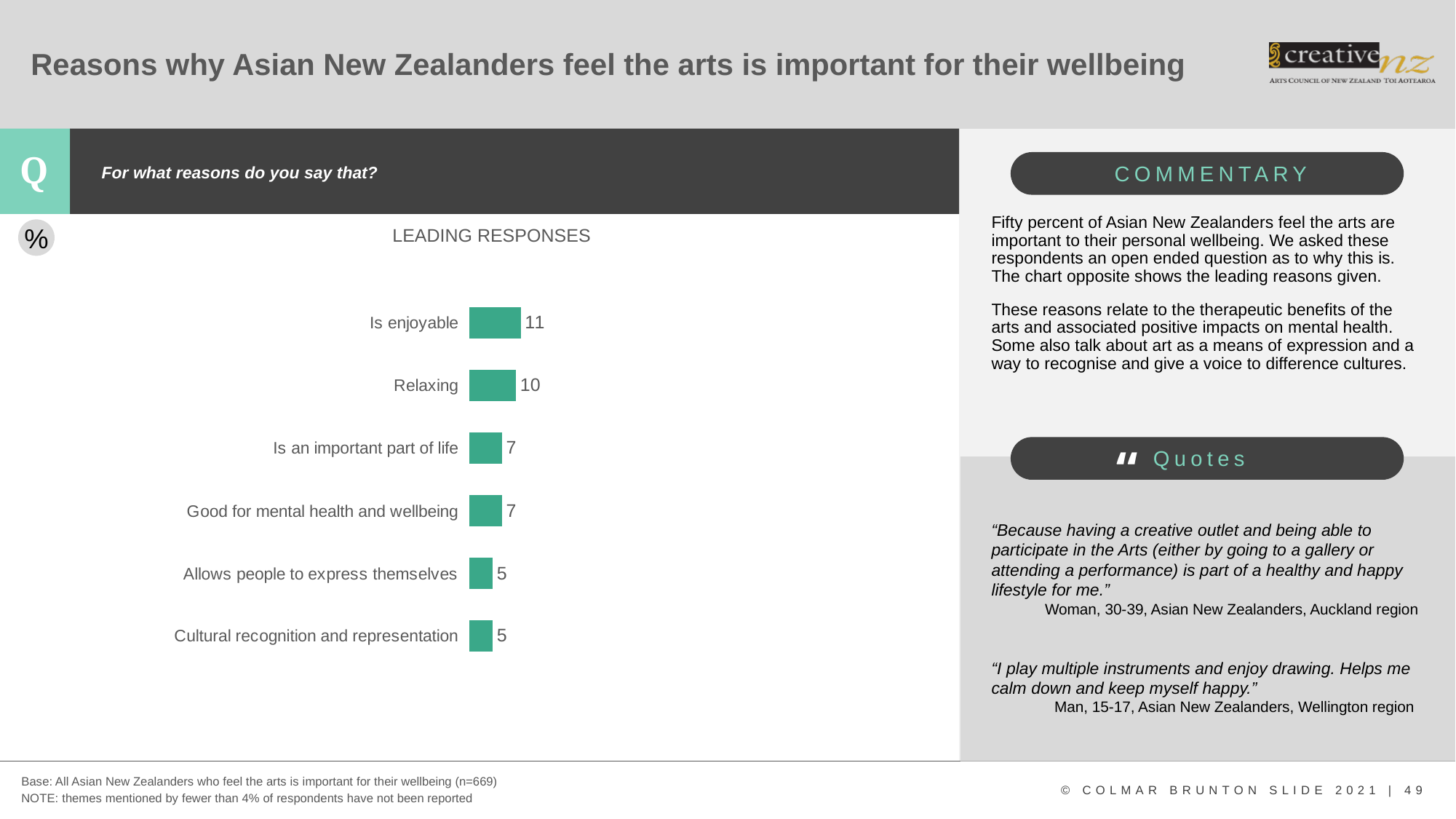
What is the title of the chart? LEADING RESPONSES How many categories are shown in the chart? 6 What colour are the bars in the chart? Green What is the difference between the values for "Is enjoyable" and "Cultural recognition and representation"? 6 What is the value for "Relaxing"? 10 What is the value for "Allows people to express themselves"? 5 What is the value for "Good for mental health and wellbeing"? 7 Which is larger, the value for "Relaxing" or the value for "Is an important part of life"? Relaxing Which category has the highest value? Is enjoyable What is the value for "Is enjoyable"? 11 What kind of chart is shown on the slide? Bar chart What is the difference between the values for "Is enjoyable" and "Relaxing"? 1